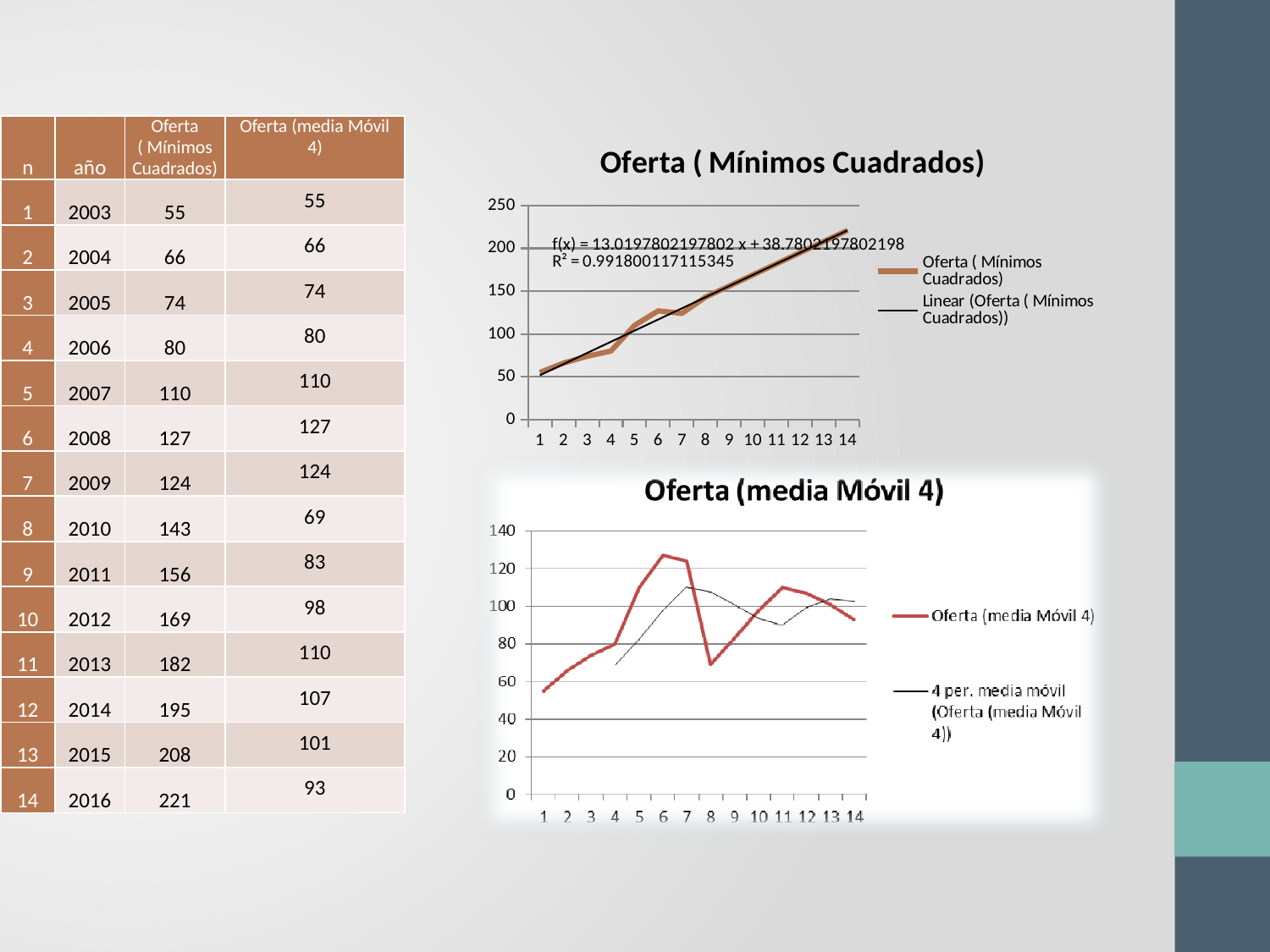
In the "Oferta (media Móvil 4)" chart, which is larger for the Oferta (media Móvil 4) series: the value at point 11 or at point 14? point 11 In the "Oferta ( Mínimos Cuadrados)" chart, is the value at point 14 greater or less than 200? greater How many series does the legend of the "Oferta (media Móvil 4)" chart list? 2 In the "Oferta (media Móvil 4)" chart, at which point is the Oferta (media Móvil 4) series lowest? 1 In the "Oferta (media Móvil 4)" chart, at which point does the Oferta (media Móvil 4) series reach its highest value? 6 In the "Oferta (media Móvil 4)" chart, is the value of the Oferta (media Móvil 4) series at point 8 greater or less than 80? less What kind of chart is the "Oferta ( Mínimos Cuadrados)" chart? line chart What kind of chart is the "Oferta (media Móvil 4)" chart? line chart How many points are plotted along the x axis of the "Oferta ( Mínimos Cuadrados)" chart? 14 What R² value is shown on the "Oferta ( Mínimos Cuadrados)" chart? 0.991800117115345 How many series does the legend of the "Oferta ( Mínimos Cuadrados)" chart list? 2 In the "Oferta ( Mínimos Cuadrados)" chart, do the values rise or fall from point 1 to point 14? rise